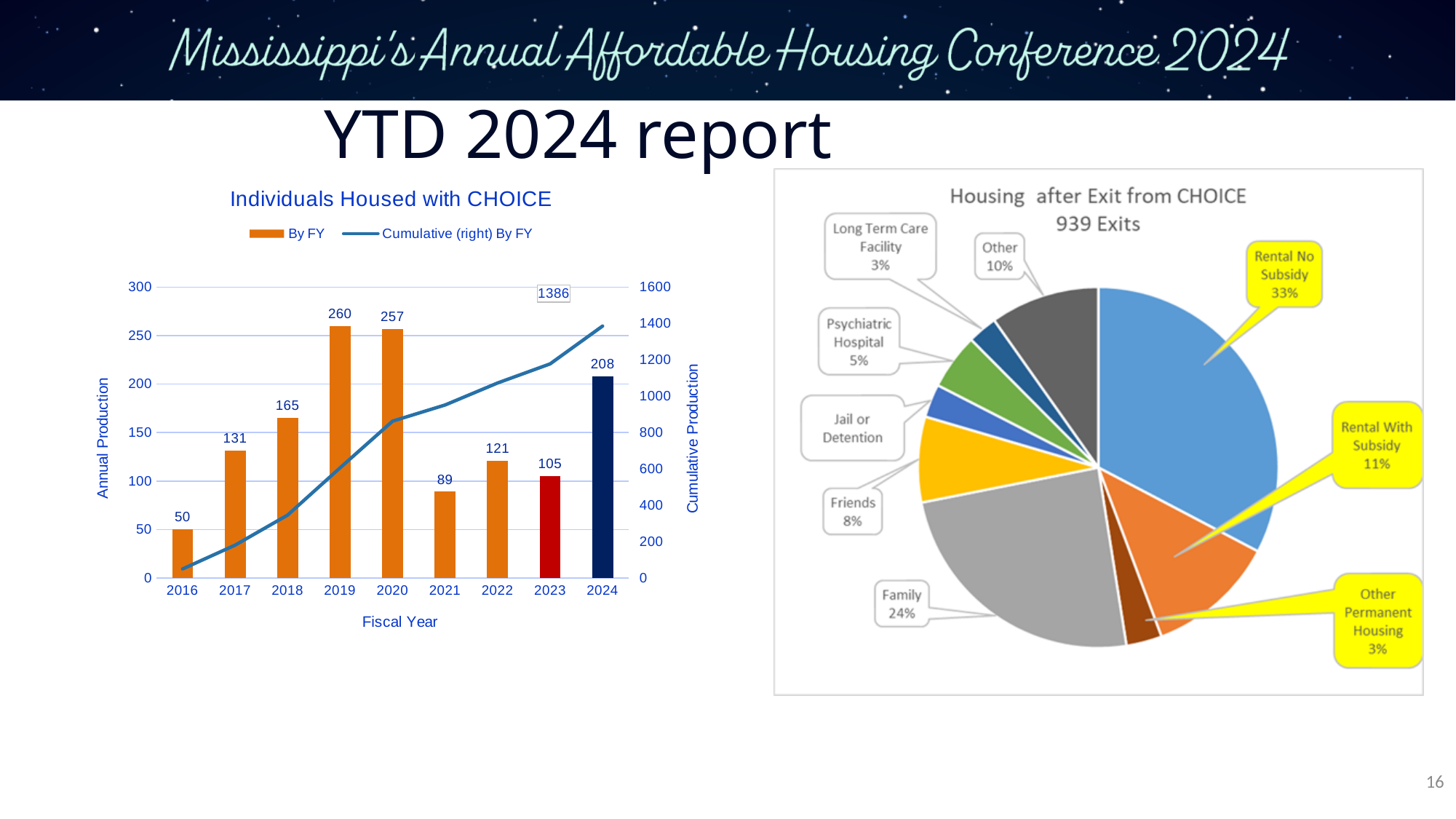
In the 'Individuals Housed with CHOICE' chart, what is the annual production value for 2024? 208 In the 'Individuals Housed with CHOICE' chart, which year has the larger annual production, 2022 or 2023? 2022 In the 'Individuals Housed with CHOICE' chart, what is the cumulative production value labelled on the line? 1386 In the 'Individuals Housed with CHOICE' chart, how many series does the legend list? 2 In the 'Housing after Exit from CHOICE' chart, which category has the largest share? Rental No Subsidy In the 'Individuals Housed with CHOICE' chart, which fiscal year has the highest annual production? 2019 In the 'Individuals Housed with CHOICE' chart, what is the annual production value for 2019? 260 In the 'Housing after Exit from CHOICE' chart, what share of exits went to Rental No Subsidy? 33% In the 'Individuals Housed with CHOICE' chart, what is the difference between the annual production for 2018 and 2017? 34 What kind of chart is the 'Housing after Exit from CHOICE' chart? Pie chart In the 'Individuals Housed with CHOICE' chart, which fiscal year has the lowest annual production? 2016 In the 'Individuals Housed with CHOICE' chart, how many fiscal years are shown on the x axis? 9